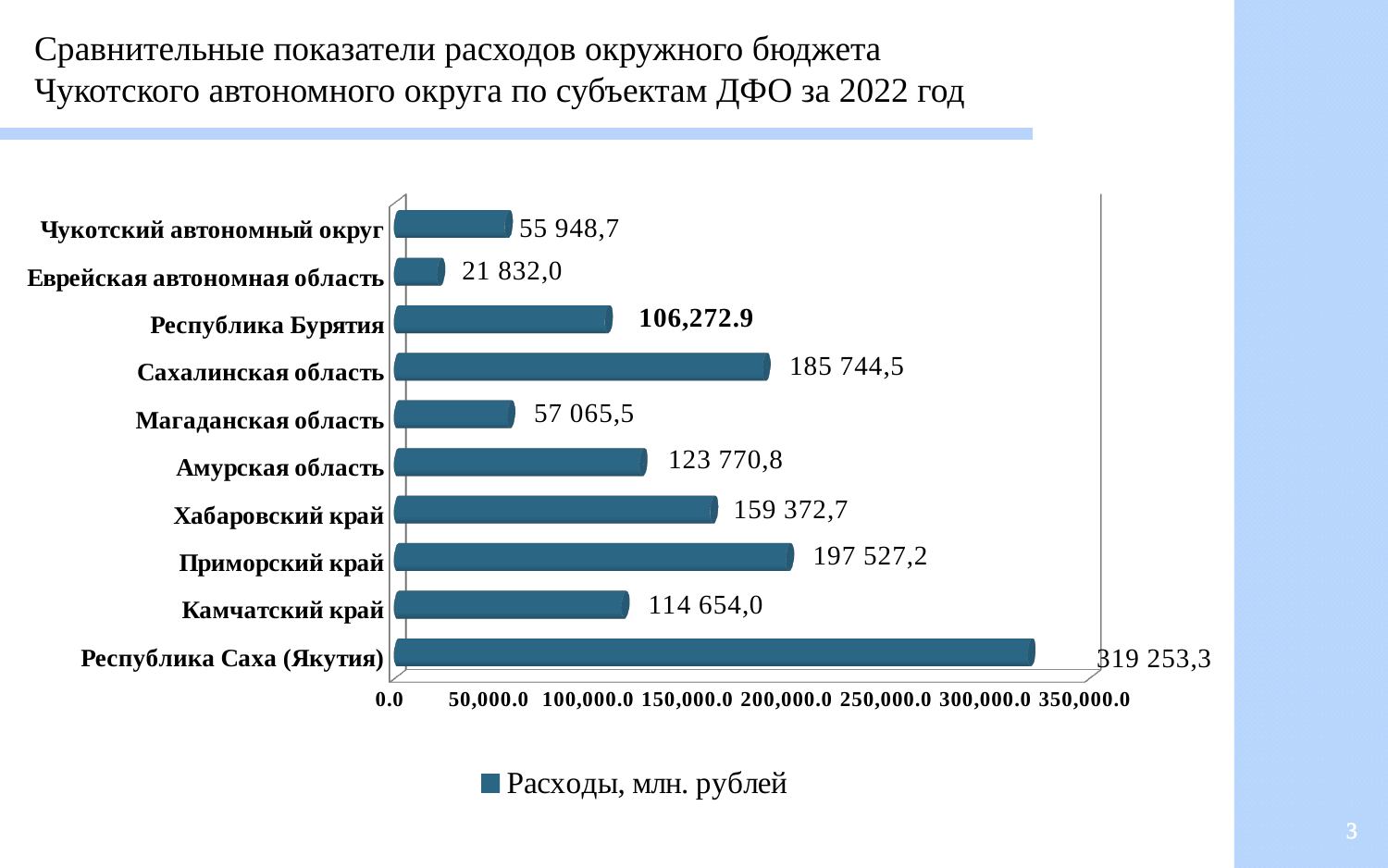
Which region has the lowest value? Еврейская автономная область What is the value for Еврейская автономная область? 21 832,0 What is the value for Хабаровский край? 159 372,7 What kind of chart is shown on the slide? bar chart Which is larger, the value for Амурская область or the value for Камчатский край? Амурская область What is the difference between the values for Приморский край and Сахалинская область? 11 782,7 How many regions are shown in the chart? 10 What is the value for Чукотский автономный округ? 55 948,7 What series does the legend list? Расходы, млн. рублей Is the value for Хабаровский край greater or less than 150,000.0? greater Which region has the highest value? Республика Саха (Якутия) What is the value for Республика Саха (Якутия)? 319 253,3